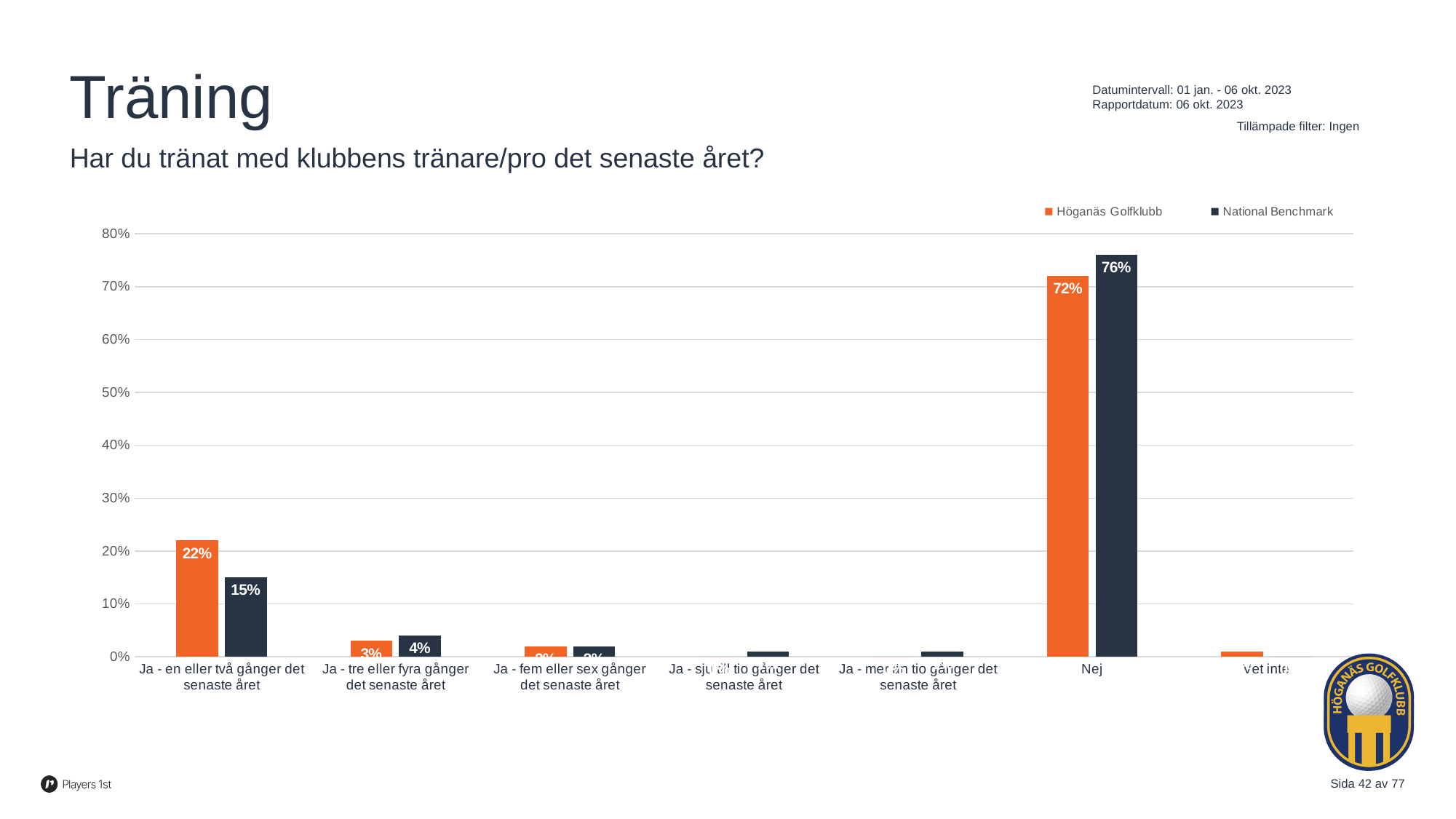
For "Nej", which series has the larger value? National Benchmark Which category has the highest value for Höganäs Golfklubb? Nej What is the difference between the National Benchmark and Höganäs Golfklubb values for "Nej"? 4 percentage points For "Ja - en eller två gånger det senaste året", which series has the larger value? Höganäs Golfklubb What is the difference between the Höganäs Golfklubb and National Benchmark values for "Ja - en eller två gånger det senaste året"? 7 percentage points What is the value for Höganäs Golfklubb for "Nej"? 72% What is the value for Höganäs Golfklubb for "Ja - en eller två gånger det senaste året"? 22% How many series does the legend list? 2 Is the Höganäs Golfklubb value for "Nej" greater or less than 70%? greater What is the National Benchmark value for "Ja - tre eller fyra gånger det senaste året"? 4% What kind of chart is shown on the slide? bar chart What is the National Benchmark value for "Nej"? 76%